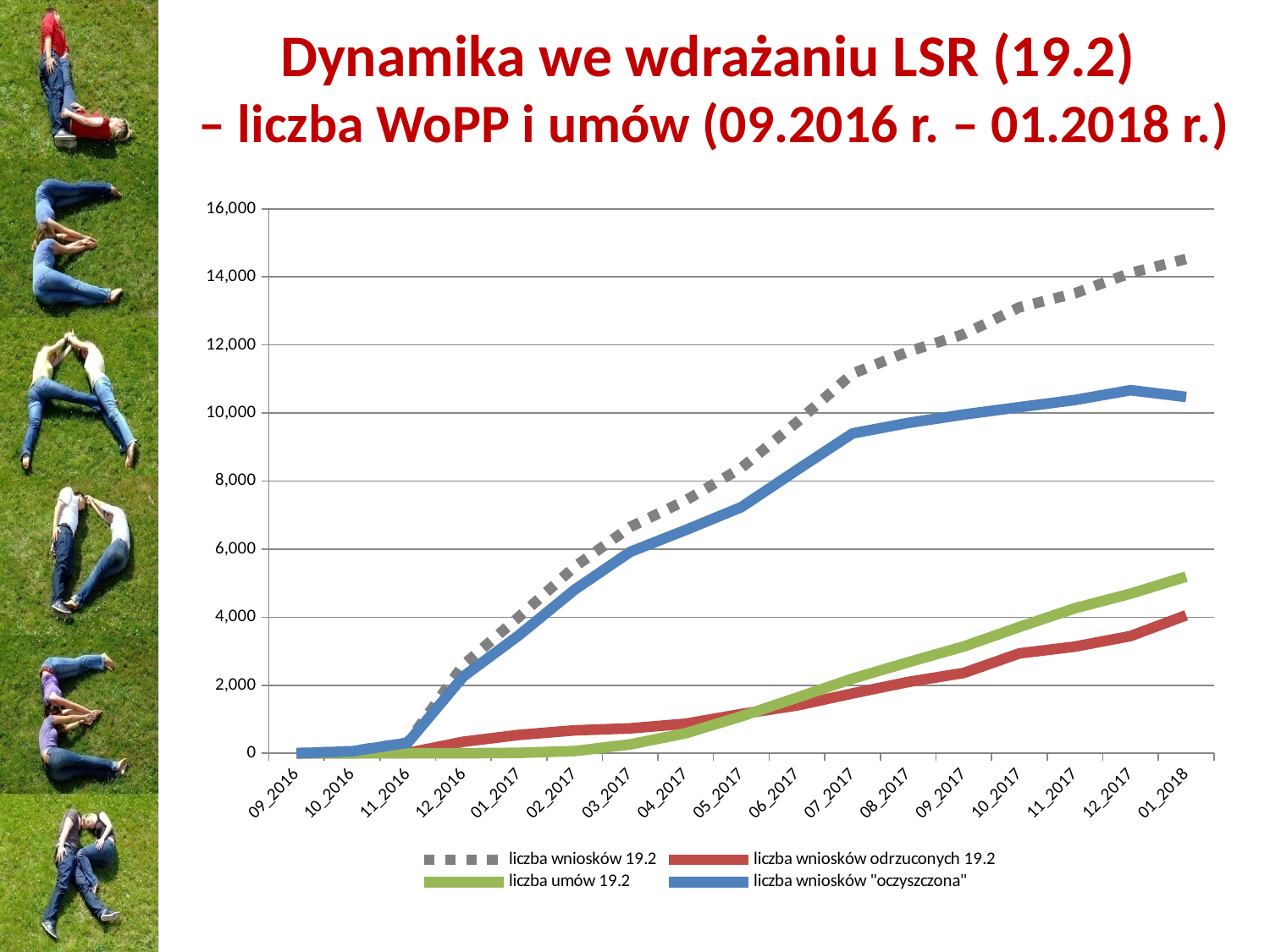
Is the value of liczba wniosków "oczyszczona" at 07_2017 greater or less than 10,000? less Is the value of liczba wniosków 19.2 at 03_2017 greater or less than 6,000? greater At 01_2018, which is larger: liczba umów 19.2 or liczba wniosków odrzuconych 19.2? liczba umów 19.2 Is the value of liczba wniosków 19.2 at 01_2018 greater or less than 14,000? greater Which series is drawn as a grey dashed line? liczba wniosków 19.2 How many months are shown along the x axis? 17 What kind of chart is shown on the slide? line chart Does the liczba wniosków 19.2 series rise or fall from 09_2016 to 01_2018? rise How many series does the legend list? 4 Which series has the highest value at 01_2018? liczba wniosków 19.2 At 03_2017, which is larger: liczba wniosków odrzuconych 19.2 or liczba umów 19.2? liczba wniosków odrzuconych 19.2